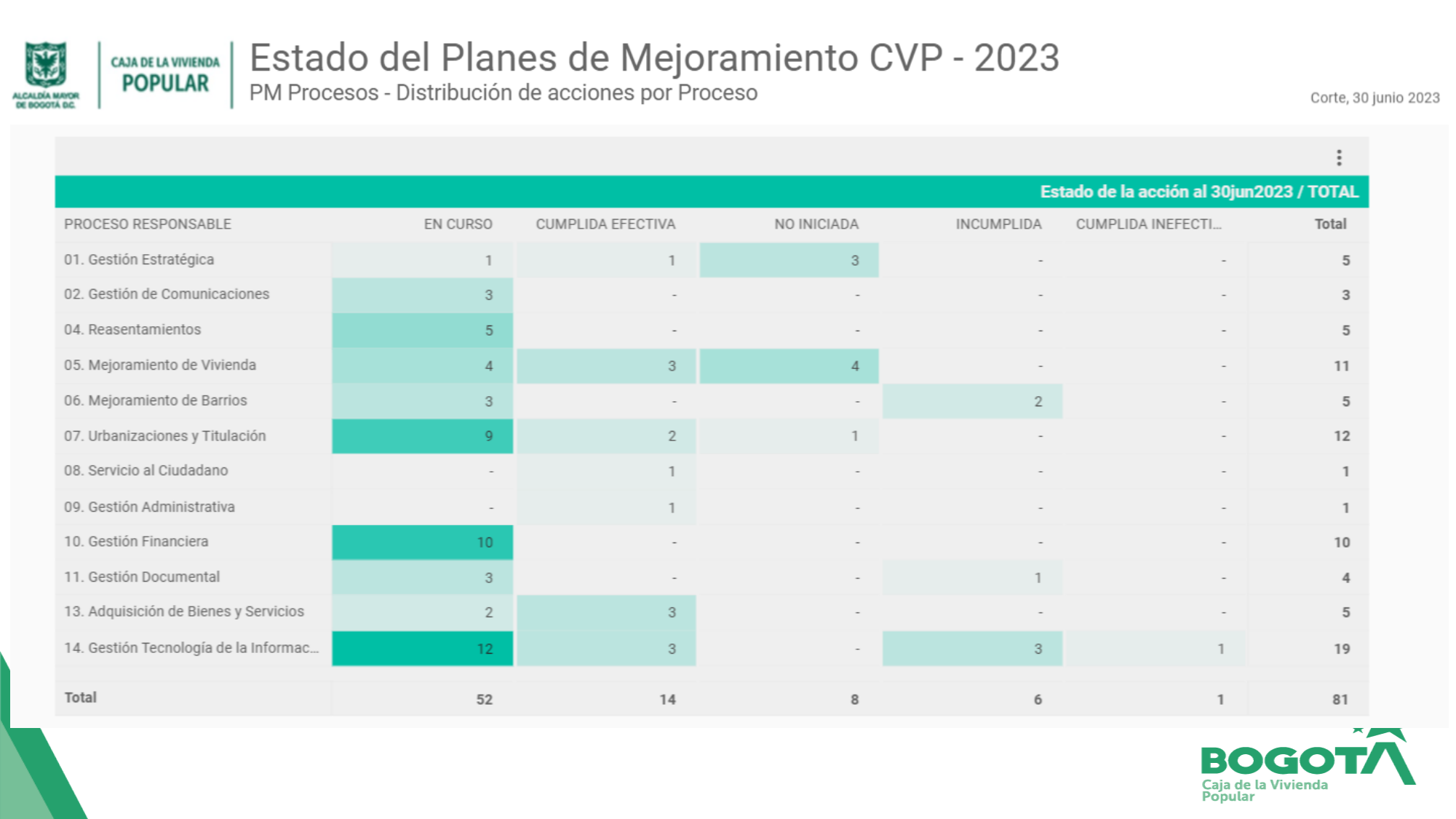
Which process has the highest Total? 14. Gestión Tecnología de la Informac... What is the overall Total of all actions shown in the bottom row? 81 How many processes (rows, excluding the Total row) are listed in the table? 12 What is the Total for 05. Mejoramiento de Vivienda? 11 Which has a larger Total, 07. Urbanizaciones y Titulación or 10. Gestión Financiera? 07. Urbanizaciones y Titulación How many actions does 10. Gestión Financiera have in the EN CURSO column? 10 What is the column total for CUMPLIDA EFECTIVA? 14 How many NO INICIADA actions does 01. Gestión Estratégica have? 3 How many action status columns are shown before the Total column? 5 Which process has the highest EN CURSO value? 14. Gestión Tecnología de la Informac... What is the difference between the EN CURSO values of 07. Urbanizaciones y Titulación and 04. Reasentamientos? 4 What is the subtitle of the slide below the main title? PM Procesos - Distribución de acciones por Proceso